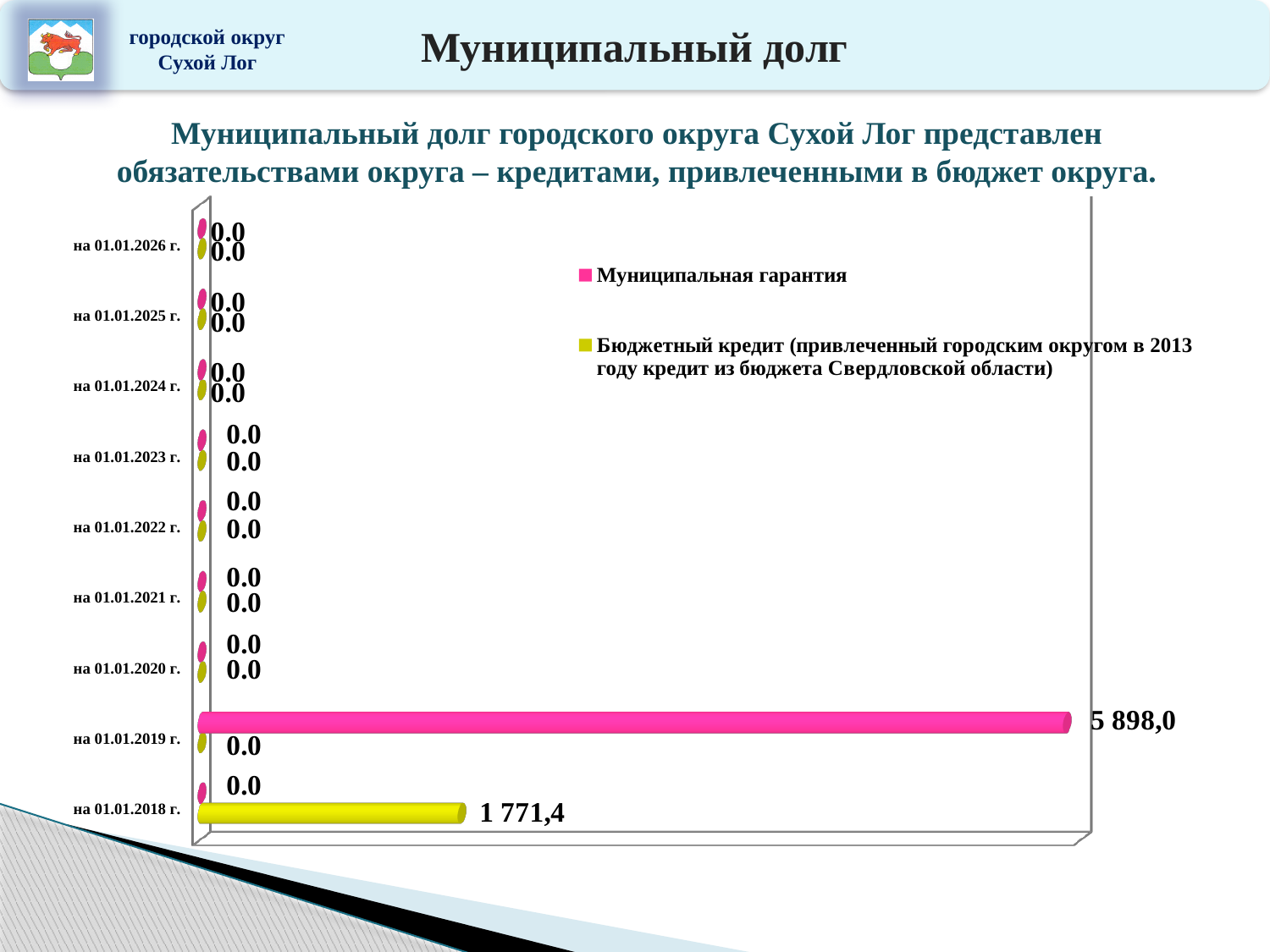
For which date is the Бюджетный кредит value highest? на 01.01.2018 г. How many date categories are shown on the chart? 9 What colour are the bars for the Муниципальная гарантия series? pink What kind of chart is shown on the slide? bar chart What is the value of Бюджетный кредит for на 01.01.2018 г.? 1 771,4 What is the value of Бюджетный кредит for на 01.01.2019 г.? 0.0 How many series does the chart legend list? 2 Which is larger: Муниципальная гарантия for на 01.01.2019 г. or Бюджетный кредит for на 01.01.2018 г.? Муниципальная гарантия for на 01.01.2019 г. For which date is the Муниципальная гарантия value highest? на 01.01.2019 г. What is the value of Бюджетный кредит for на 01.01.2024 г.? 0.0 What is the value of Муниципальная гарантия for на 01.01.2018 г.? 0.0 What is the value of Муниципальная гарантия for на 01.01.2019 г.? 5 898,0